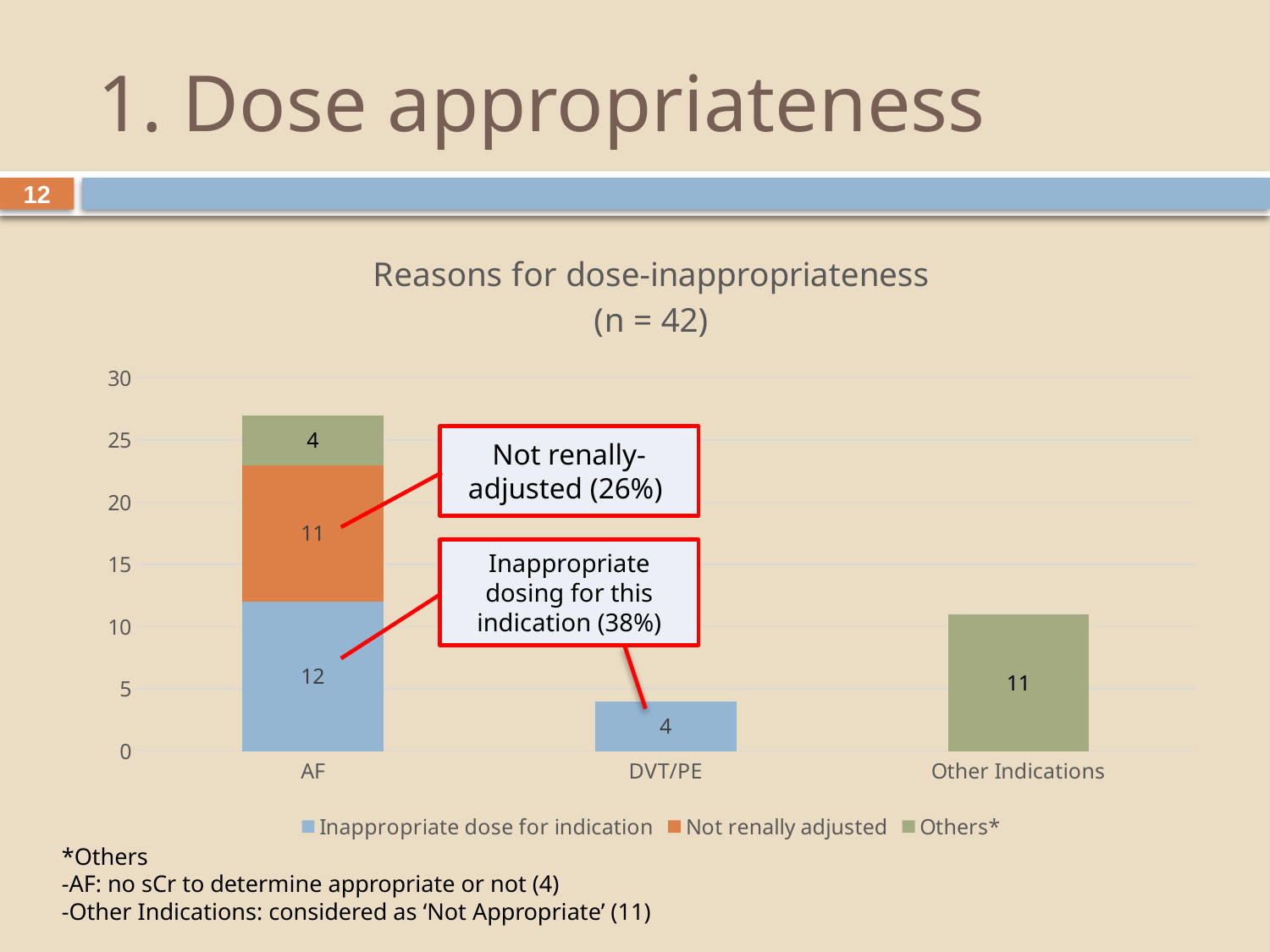
What type of chart is shown? Stacked bar chart Which category has the tallest stacked bar? AF What is the value of 'Others*' for Other Indications? 11 Which category has the shortest bar? DVT/PE What is the difference between the 'Inappropriate dose for indication' values for AF and DVT/PE? 8 What is the value of 'Not renally adjusted' for AF? 11 What is the value of 'Inappropriate dose for indication' for AF? 12 How many series does the legend list? 3 What is the total of the stacked bar for AF? 27 How many categories are shown on the x axis? 3 What is the value of 'Inappropriate dose for indication' for DVT/PE? 4 Is the 'Inappropriate dose for indication' value for AF larger or smaller than the 'Others*' value for Other Indications? larger